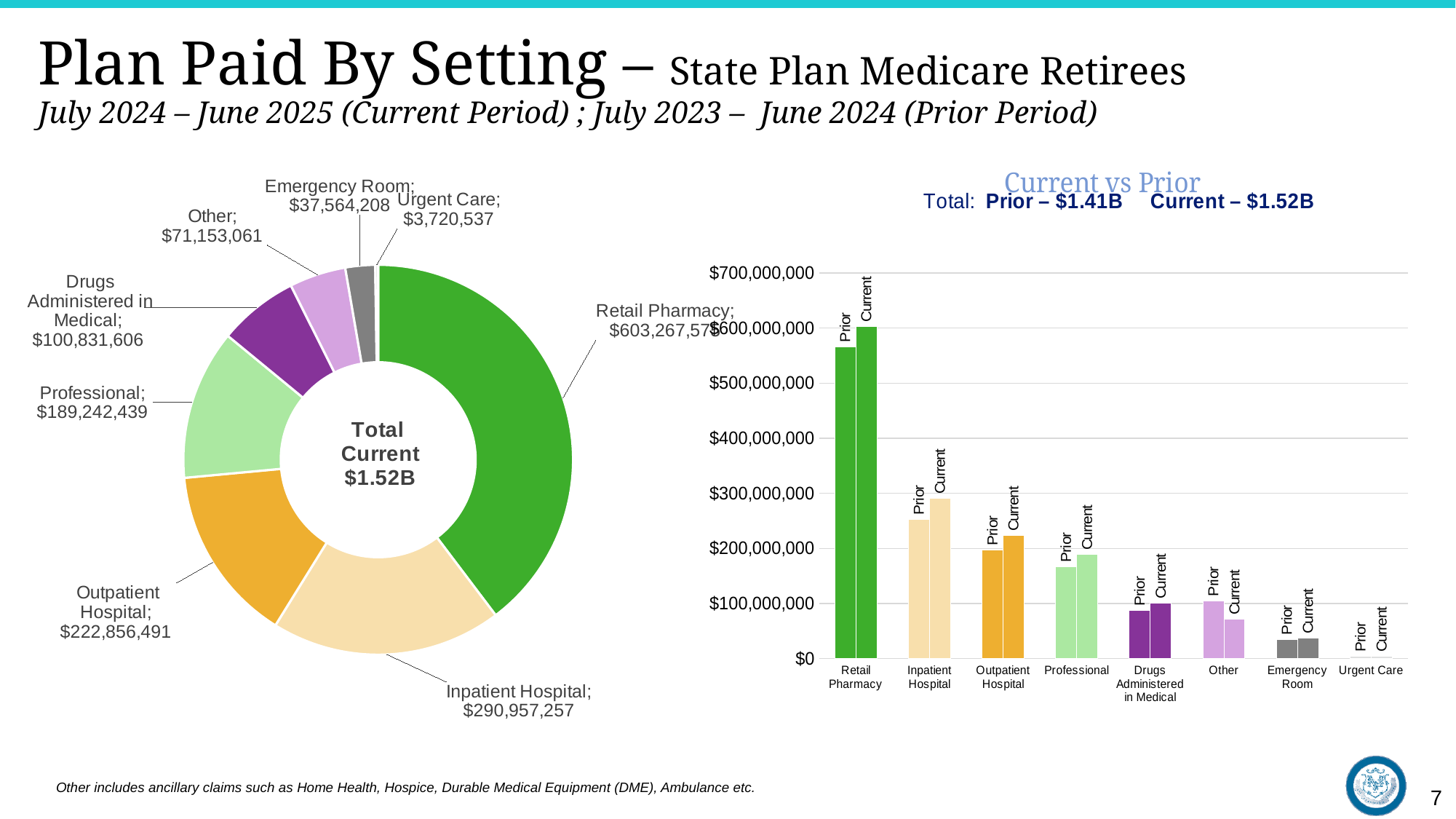
How many settings are shown in the donut chart on the left? 8 In the donut chart on the left, which setting has the largest value? Retail Pharmacy In the donut chart on the left, which setting has the smallest value? Urgent Care What total is shown in the center of the donut chart on the left? $1.52B In the 'Current vs Prior' bar chart, which is larger for Other: Prior or Current? Prior In the 'Current vs Prior' bar chart, is the Prior value for Retail Pharmacy greater or less than $600,000,000? less What kind of chart is the 'Current vs Prior' chart on the right? Bar chart In the 'Current vs Prior' bar chart, is the Current value for Outpatient Hospital greater or less than $200,000,000? greater In the donut chart on the left, what is the value for Urgent Care? $3,720,537 In the donut chart on the left, what is the value for Inpatient Hospital? $290,957,257 In the donut chart on the left, what is the difference between Outpatient Hospital and Professional? $33,614,052 According to the 'Current vs Prior' chart, what is the Prior total? $1.41B